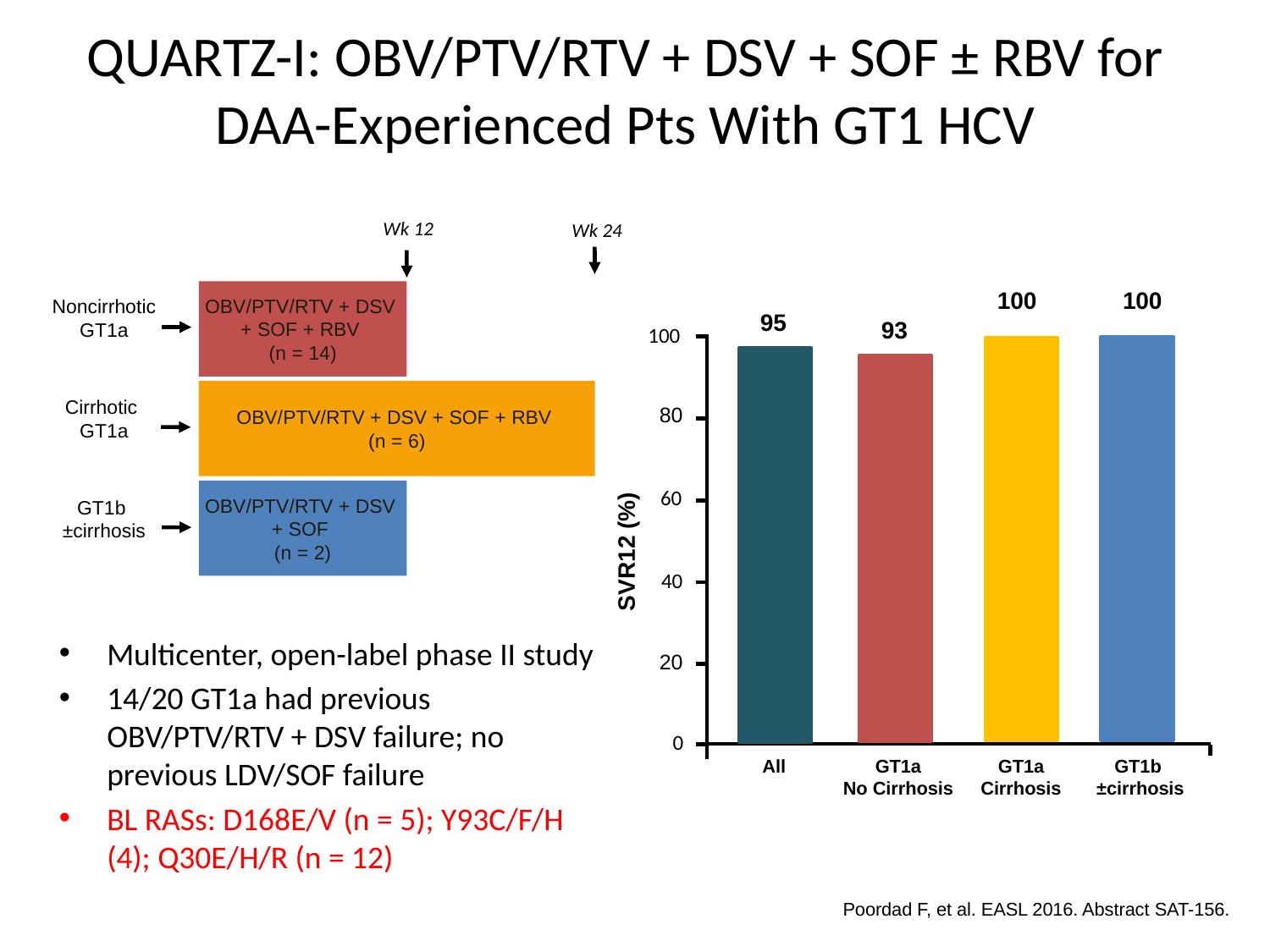
What is the difference in SVR12 (%) between the All group and GT1a No Cirrhosis? 2 Is the SVR12 (%) value for GT1a No Cirrhosis greater or less than 80? greater How many groups are shown on the x axis of the bar chart? 4 What is the SVR12 (%) value for GT1b ±cirrhosis? 100 What is the label of the y axis of the chart? SVR12 (%) What is the SVR12 (%) value for the All group? 95 What is the SVR12 (%) value for GT1a Cirrhosis? 100 Which group has the lowest SVR12 (%)? GT1a No Cirrhosis What kind of chart is used to show SVR12 (%)? Bar chart Which has a higher SVR12 (%): All or GT1a No Cirrhosis? All What is the difference in SVR12 (%) between GT1a Cirrhosis and GT1a No Cirrhosis? 7 What is the SVR12 (%) value for GT1a No Cirrhosis? 93